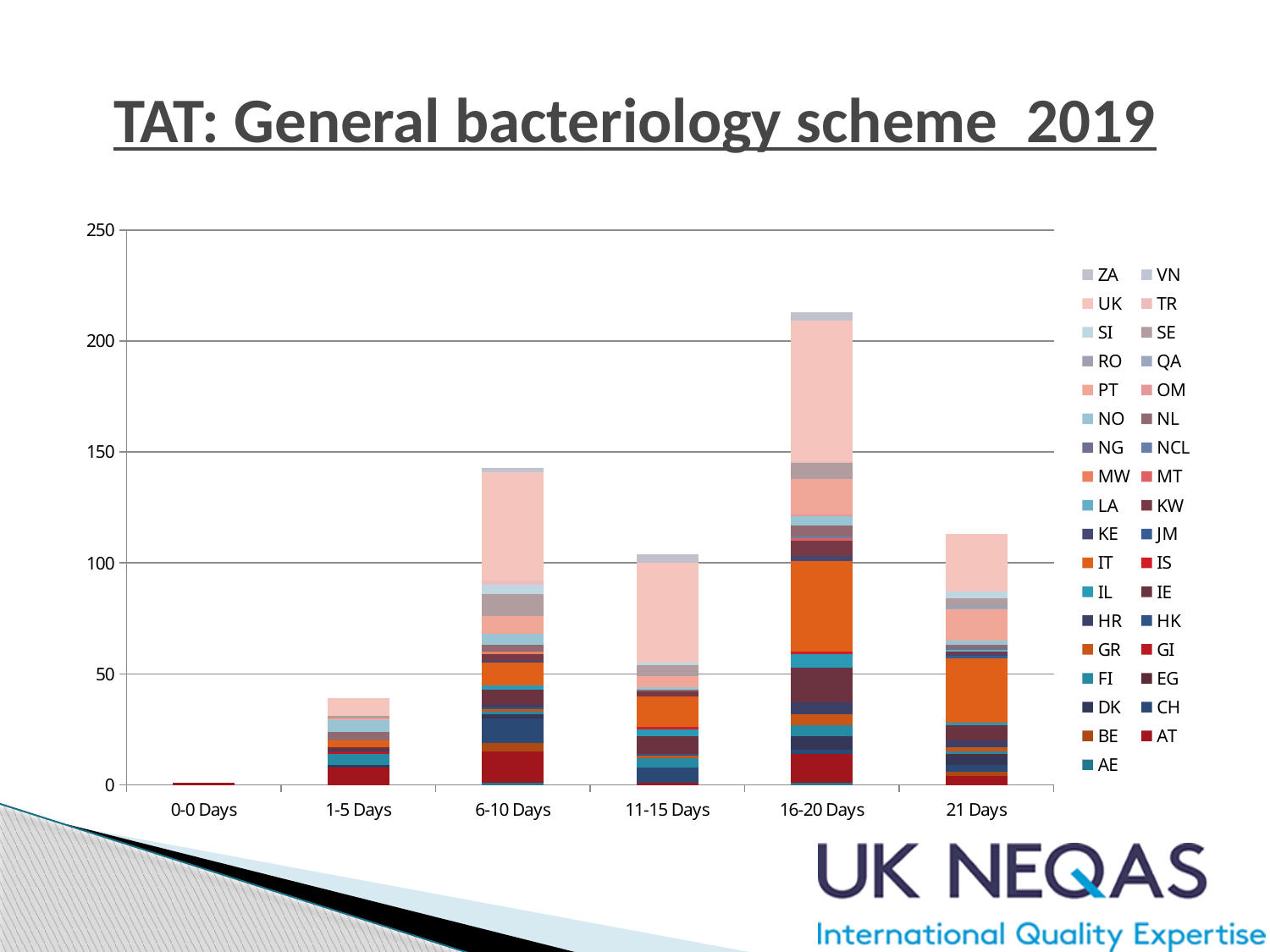
Which category has the shortest stacked bar? 0-0 Days Which stacked bar is taller, 6-10 Days or 21 Days? 6-10 Days What is the title of the chart on the slide? TAT: General bacteriology scheme 2019 Is the total for 1-5 Days greater or less than 50? less Is the total for 6-10 Days greater or less than 150? less How many series does the legend list? 35 How many categories are shown on the x axis? 6 Which category has the tallest stacked bar? 16-20 Days Is the total for 16-20 Days greater or less than 200? greater What kind of chart is shown on the slide? Stacked bar chart Which stacked bar is taller, 1-5 Days or 11-15 Days? 11-15 Days